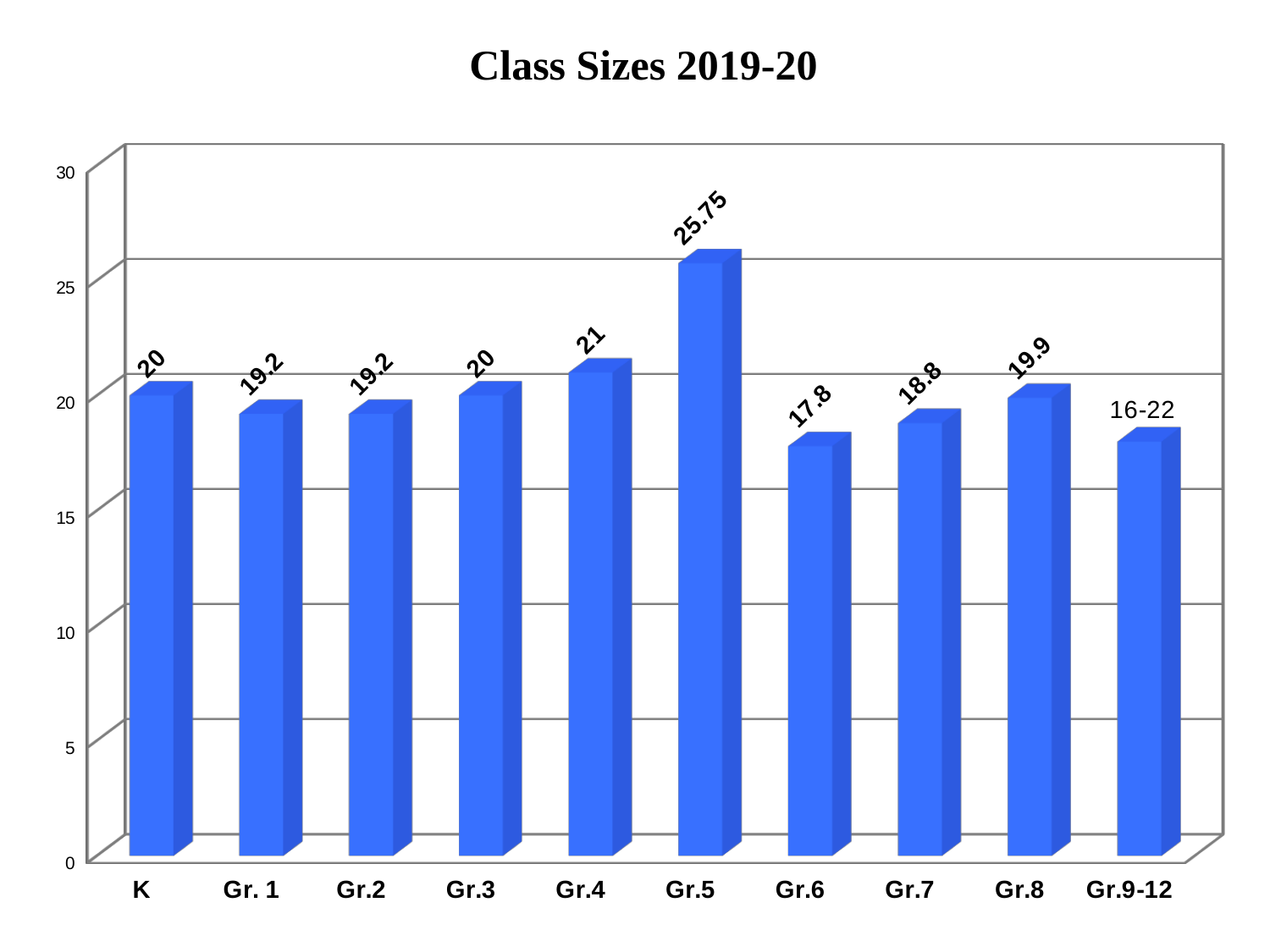
What kind of chart is this? bar chart Which grade has the smallest labelled class size? Gr.6 What label is shown above the Gr.9-12 bar? 16-22 What is the title of the chart? Class Sizes 2019-20 Which grade has the largest class size? Gr.5 What is the difference between the class sizes for Gr.8 and Gr.6? 2.1 What is the class size shown for Gr.5? 25.75 Which has a larger class size, Gr.4 or Gr.7? Gr.4 What is the class size shown for Gr.7? 18.8 Is the value for Gr.5 greater or less than 25? greater How many grade categories are shown on the x axis? 10 What is the difference between the class sizes for Gr.5 and Gr.4? 4.75